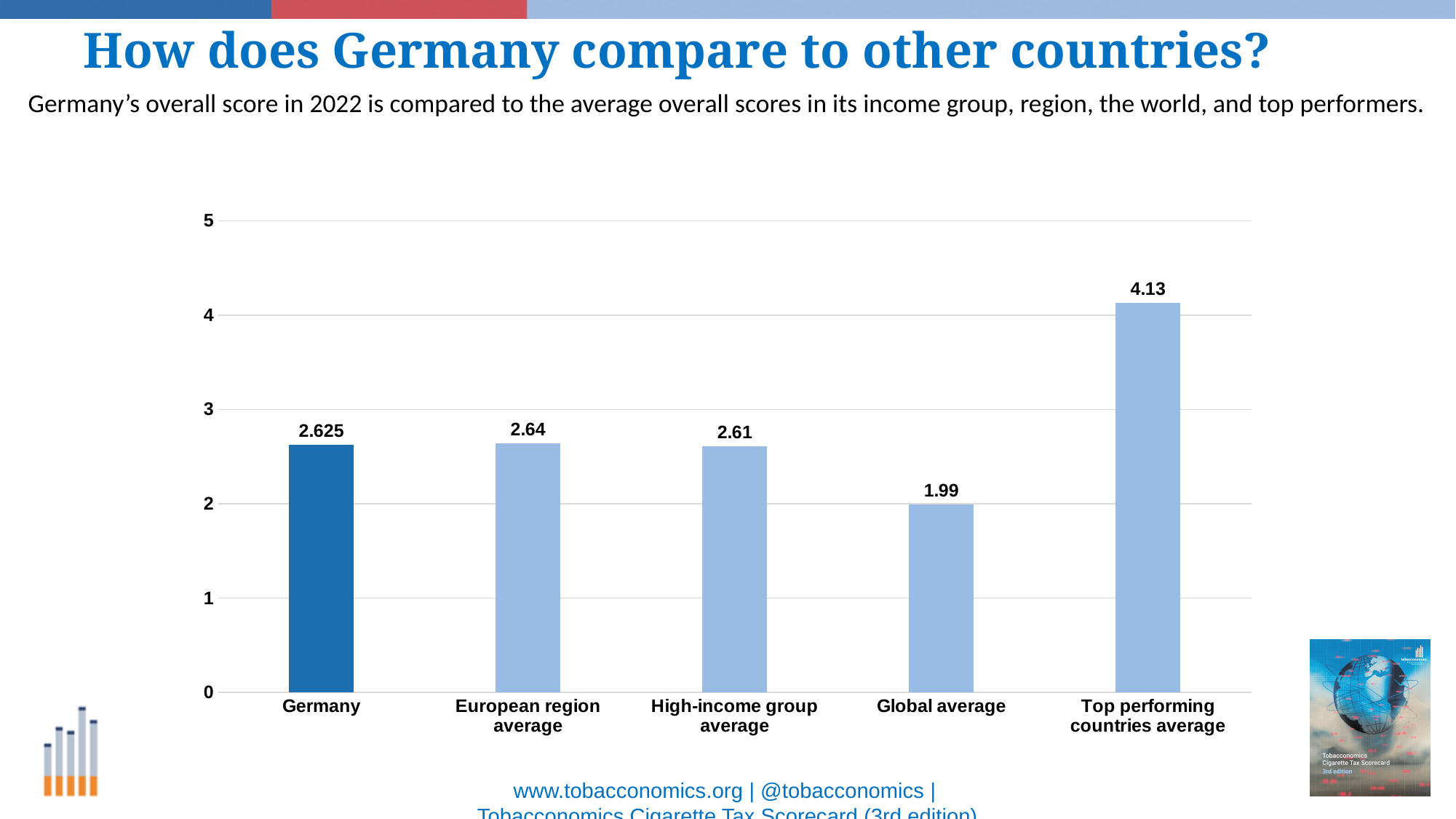
What is the value shown for the High-income group average? 2.61 What is the value shown for the Top performing countries average? 4.13 What is the value shown for the Global average? 1.99 Is the value for the Top performing countries average greater or less than 4? greater What is the difference between the Top performing countries average and the Global average? 2.14 How many categories are shown on the x axis? 5 Which is larger, the value for Germany or the Global average? Germany Which category has the lowest value? Global average What is the difference between the European region average and Germany? 0.015 What is the value shown for Germany? 2.625 What kind of chart is shown on the slide? Bar chart Which category has the highest value? Top performing countries average